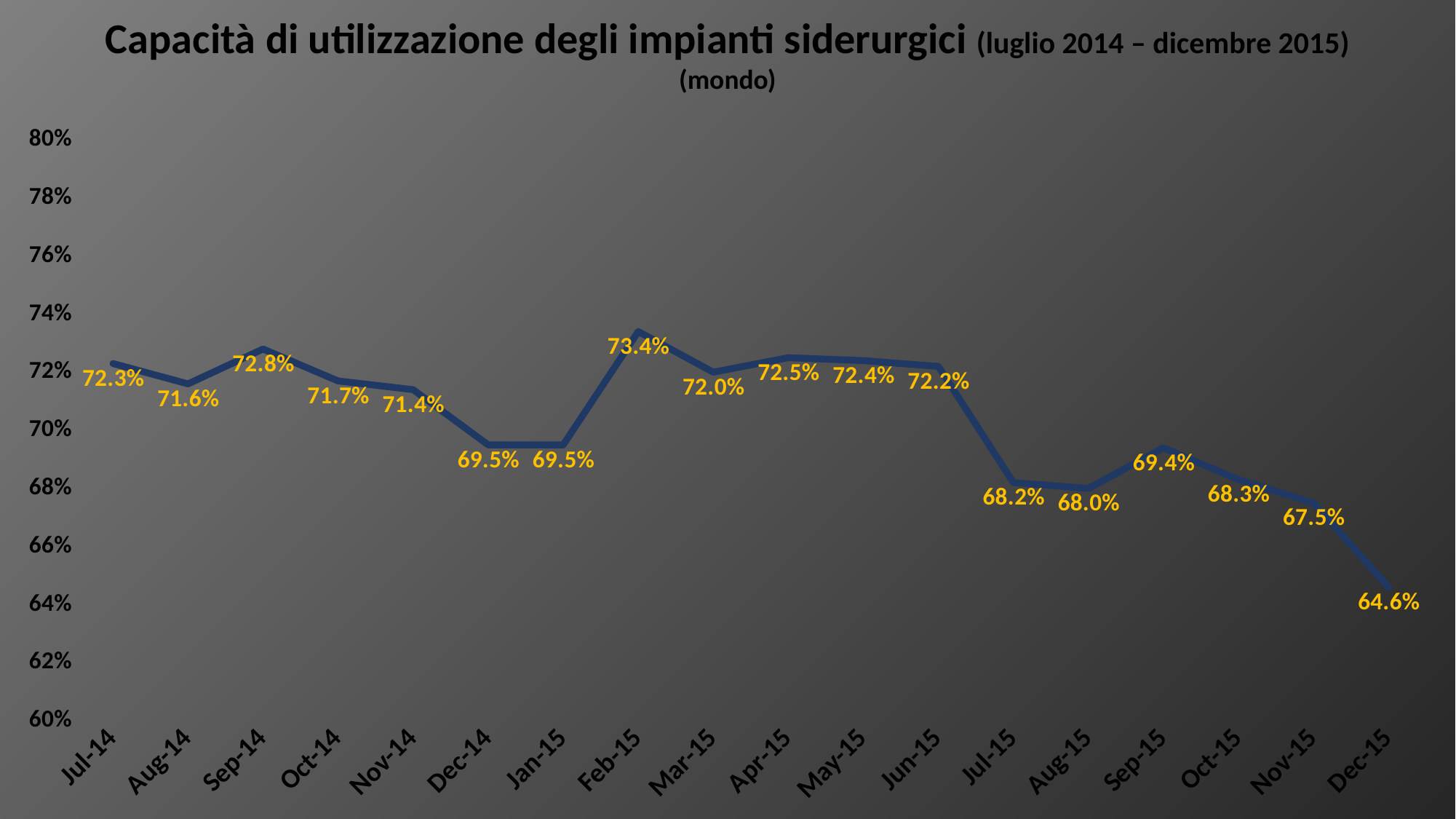
Which is larger, the value for Sep-15 or the value for Oct-15? Sep-15 What is the capacity utilization value for Feb-15? 73.4% Does the capacity utilization generally rise or fall from Jun-15 to Dec-15? fall Which month has the highest capacity utilization? Feb-15 What is the difference between the values for Jun-15 and Jul-15? 4.0% What is the capacity utilization value for Dec-15? 64.6% How many months are plotted on the chart? 18 What is the difference between the values for Feb-15 and Dec-15? 8.8% Is the value for Nov-15 greater or less than 68%? less Which month has the lowest capacity utilization? Dec-15 What is the value shown for Sep-14? 72.8% What type of chart is shown on the slide? line chart